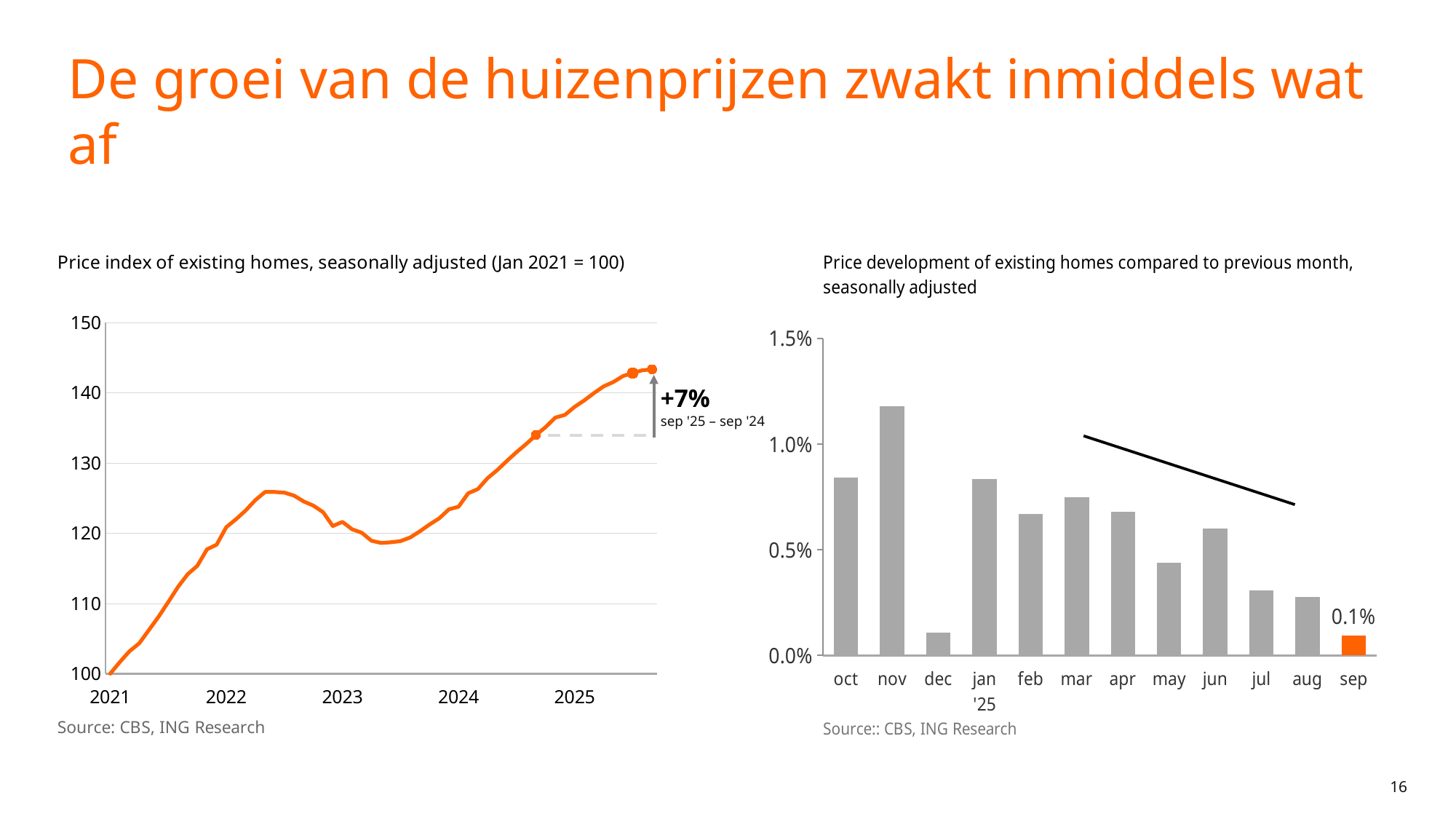
In the right chart, is the value for may greater or less than 0.5%? less What kind of chart is the right chart, 'Price development of existing homes compared to previous month, seasonally adjusted'? bar chart In the left chart, what percentage change is annotated for sep '25 compared to sep '24? +7% In the right chart, which is larger, the value for jun or the value for jul? jun What kind of chart is the left chart, 'Price index of existing homes, seasonally adjusted (Jan 2021 = 100)'? line chart In the right chart, how many months are shown? 12 In the right chart, is the value for nov greater or less than 1.0%? greater In the right chart, do the values rise or fall from mar to sep? fall In the right chart, is the value for jun greater or less than 0.5%? greater In the right chart, what is the value for sep? 0.1% In the right chart, which month has the highest value? nov In the left chart, does the price index rise or fall overall from 2021 to 2025? rise